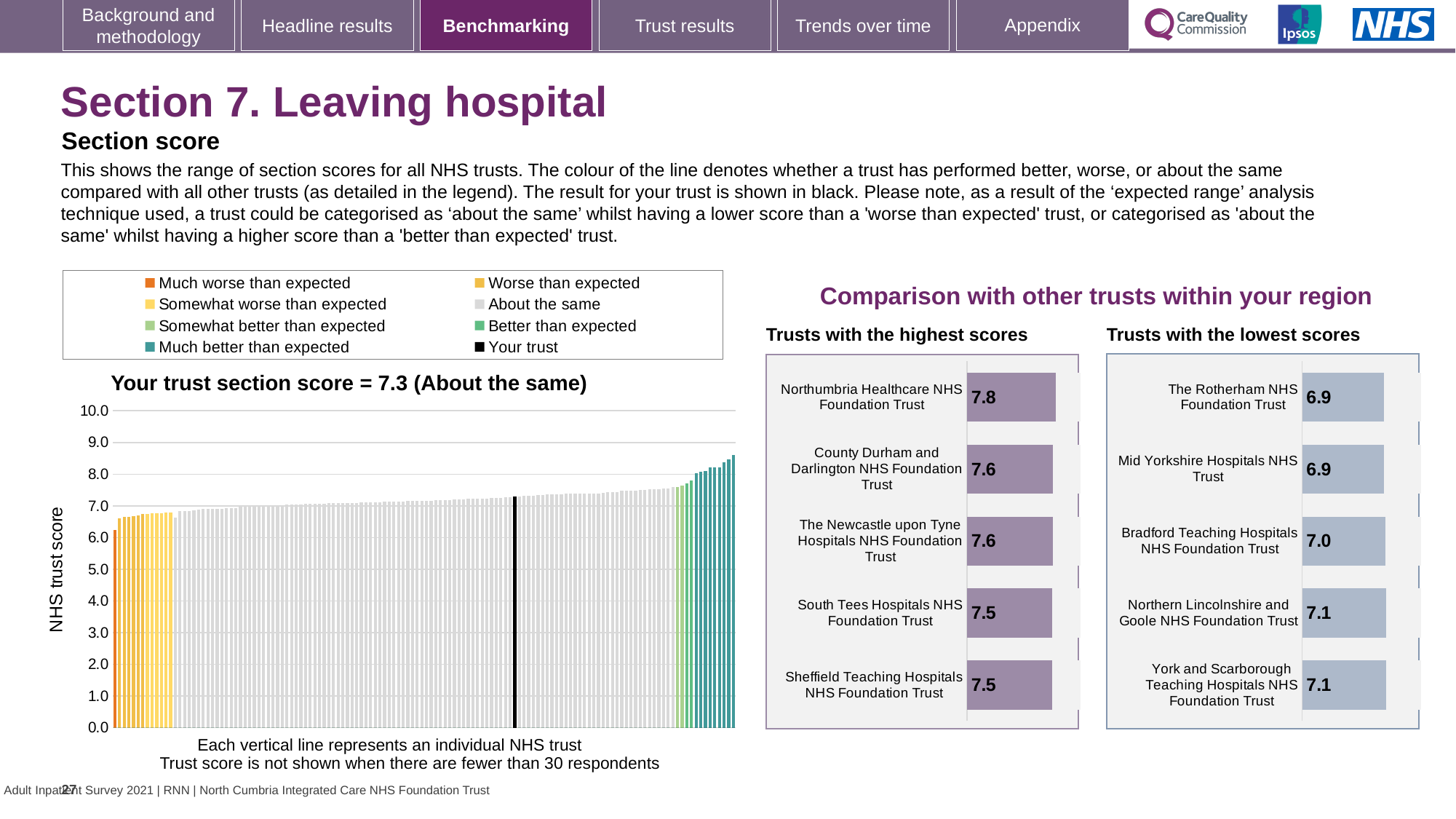
In the 'Your trust section score' chart, what category is your trust placed in? About the same What kind of chart is the 'Your trust section score' chart? bar chart What is the y-axis label of the 'Your trust section score' chart? NHS trust score How many entries does the legend above the 'Your trust section score' chart list? 8 In the 'Your trust section score' chart, what is the section score for your trust? 7.3 In the 'Your trust section score' chart, is the value of the highest bar greater or less than 8.0? greater In the 'Trusts with the lowest scores' chart, what is the score for Bradford Teaching Hospitals NHS Foundation Trust? 7.0 In the 'Trusts with the highest scores' chart, which trust has the highest score? Northumbria Healthcare NHS Foundation Trust How many trusts are shown in the 'Trusts with the lowest scores' chart? 5 In the 'Trusts with the highest scores' chart, what is the difference between the scores of Northumbria Healthcare NHS Foundation Trust and Sheffield Teaching Hospitals NHS Foundation Trust? 0.3 In the 'Trusts with the highest scores' chart, what is the score for South Tees Hospitals NHS Foundation Trust? 7.5 In the 'Trusts with the lowest scores' chart, what is the difference between the scores of York and Scarborough Teaching Hospitals NHS Foundation Trust and The Rotherham NHS Foundation Trust? 0.2